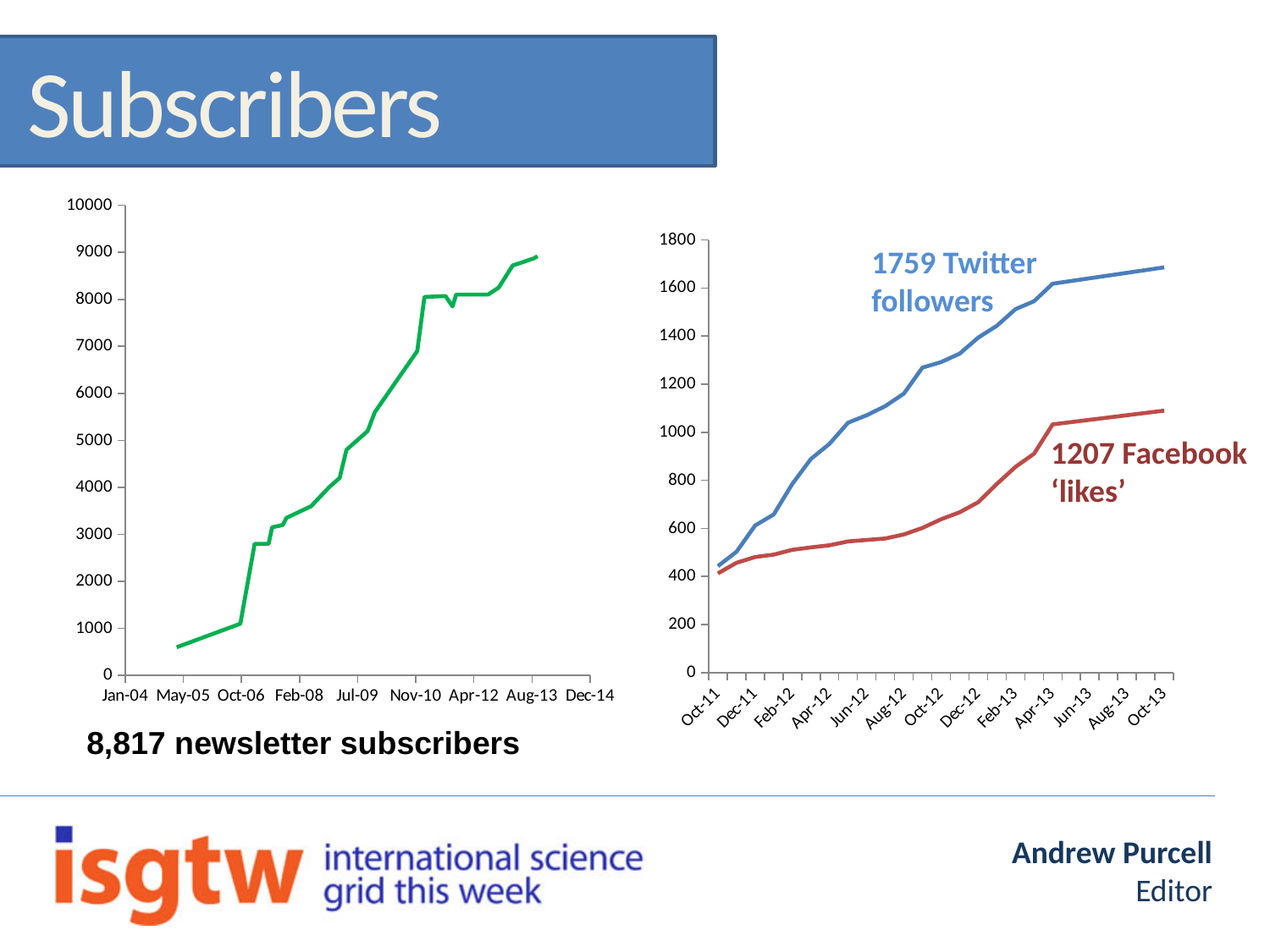
According to the text below the left chart, how many newsletter subscribers are there? 8,817 What type of chart is the left chart showing newsletter subscribers? line chart On the right chart, what is the difference between the labelled number of Twitter followers and Facebook 'likes'? 552 On the right chart, which line is higher at Oct-13, Twitter followers or Facebook 'likes'? Twitter followers On the right chart, what colour is the Twitter followers line? blue On the right chart, how many Facebook 'likes' does the label state? 1207 On the right chart, is the Facebook 'likes' value at Oct-11 greater or less than 600? less On the left chart, do newsletter subscribers generally rise or fall over time? rise How many data series are plotted on the right chart? 2 On the right chart, how many Twitter followers does the label state? 1759 On the right chart, is the Twitter followers value at Oct-13 greater or less than 1600? greater On the left chart, is the newsletter subscribers value at Oct-06 greater or less than 2000? less